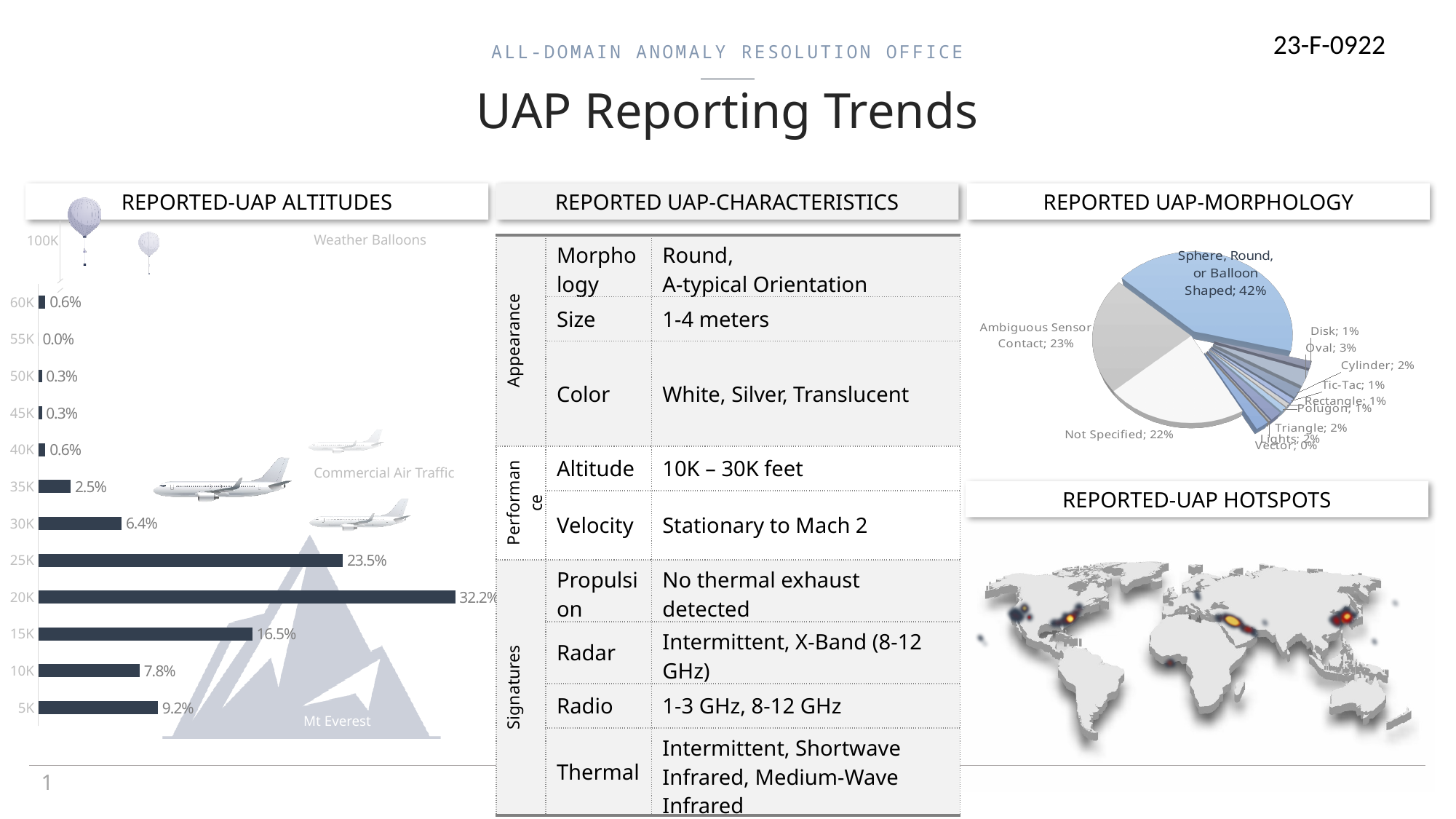
In the REPORTED-UAP ALTITUDES chart, what percentage is shown for the 5K altitude? 9.2% In the REPORTED-UAP ALTITUDES chart, which has the larger percentage, 10K or 30K? 10K What kind of chart is the REPORTED-UAP ALTITUDES chart? Bar chart How many altitude categories are shown in the REPORTED-UAP ALTITUDES chart? 12 In the REPORTED UAP-MORPHOLOGY pie chart, what share is labelled for Ambiguous Sensor Contact? 23% In the REPORTED-UAP ALTITUDES chart, what is the difference between the percentages for 25K and 15K? 7.0% In the REPORTED-UAP ALTITUDES chart, which altitude has the lowest percentage? 55K In the REPORTED-UAP ALTITUDES chart, what percentage is shown for the 20K altitude? 32.2% In the REPORTED UAP-MORPHOLOGY pie chart, what share is labelled for Oval? 3% In the REPORTED UAP-MORPHOLOGY pie chart, which category has the largest slice? Sphere, Round, or Balloon Shaped What kind of chart is the REPORTED UAP-MORPHOLOGY chart? Pie chart In the REPORTED-UAP ALTITUDES chart, which altitude has the highest percentage? 20K